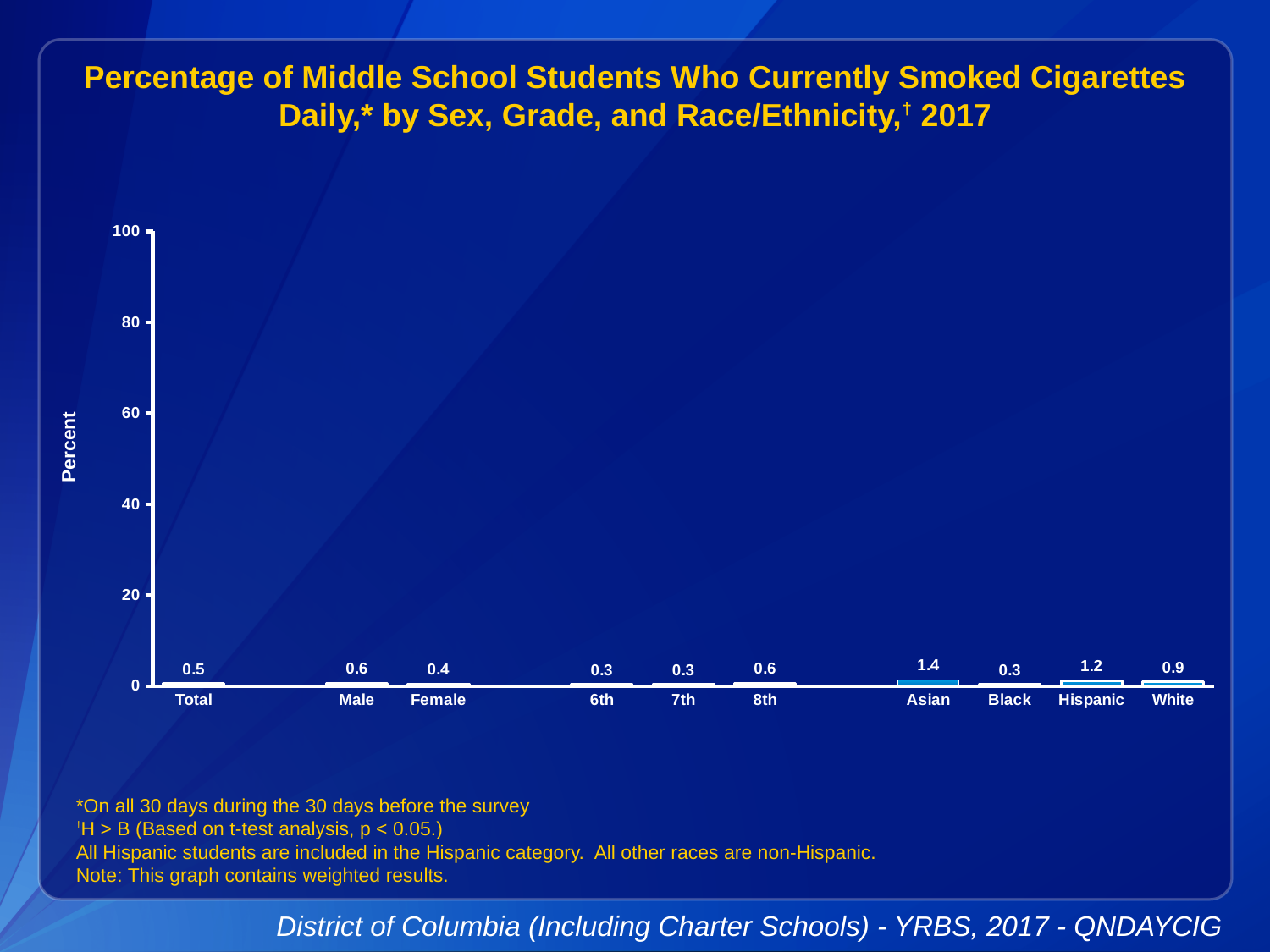
Which category has the highest value? Asian What is the value for Total? 0.5 How many categories are shown on the x axis? 10 What kind of chart is this? bar chart What is the value for Male? 0.6 What is the value for White? 0.9 Which is larger, the value for Hispanic or the value for White? Hispanic What is the difference between the values for Male and Female? 0.2 What is the difference between the values for Asian and Black? 1.1 What is the value for Hispanic? 1.2 Is the value for Asian greater or less than 20? less What is the label of the y axis? Percent